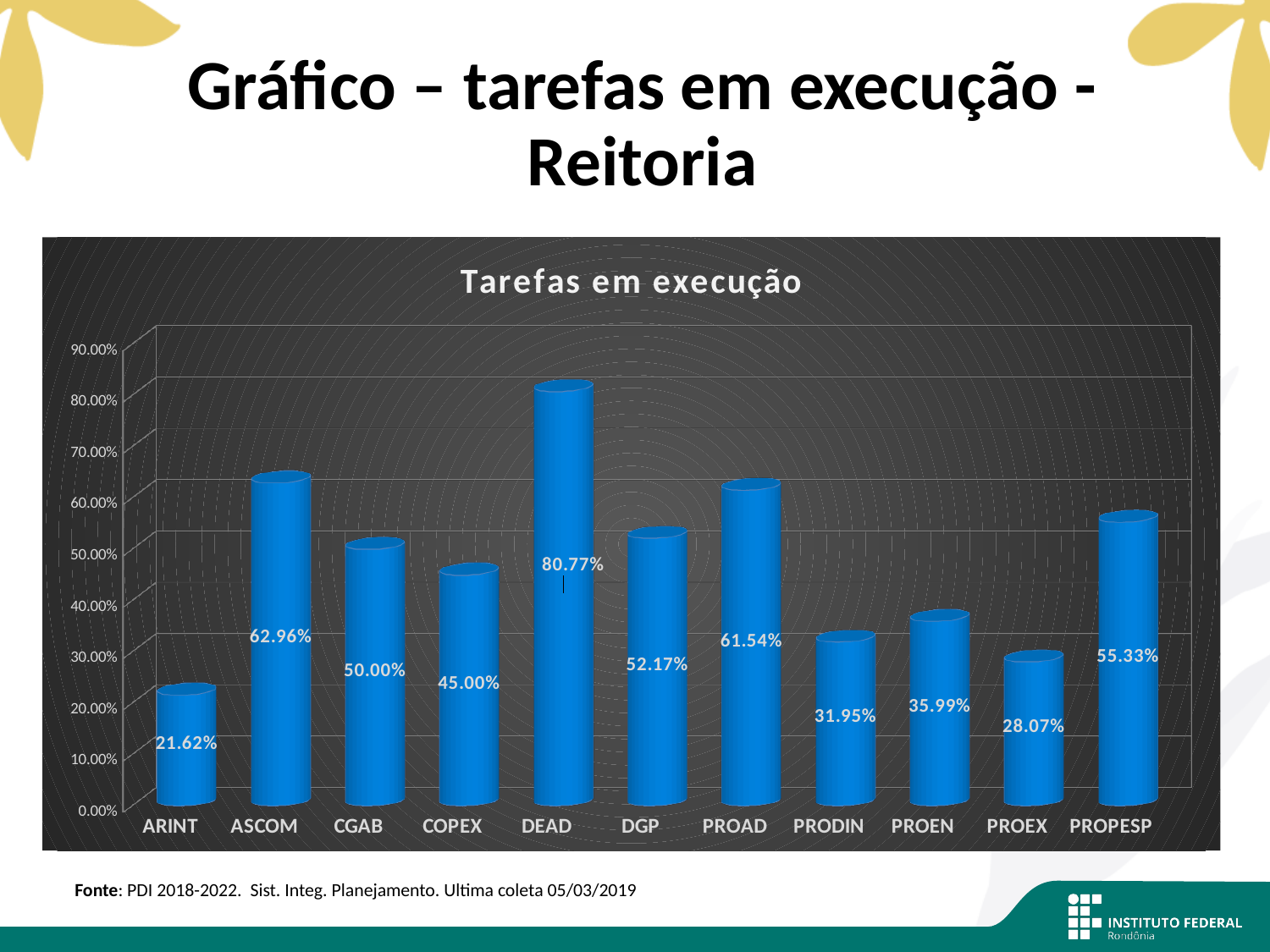
What is the title of the chart? Tarefas em execução How many categories are shown on the x axis of the chart? 11 What is the value for PRODIN in the chart? 31.95% Which category has the highest value in the chart? DEAD Which is larger, the value for CGAB or the value for DGP? DGP Which category has the lowest value in the chart? ARINT What is the value for DEAD in the chart? 80.77% Is the value for PROEN greater or less than 40.00%? less What is the difference between the values for DEAD and ARINT? 59.15% What kind of chart is shown on the slide? bar chart What is the value for PROPESP in the chart? 55.33% What is the difference between the values for ASCOM and PROAD? 1.42%